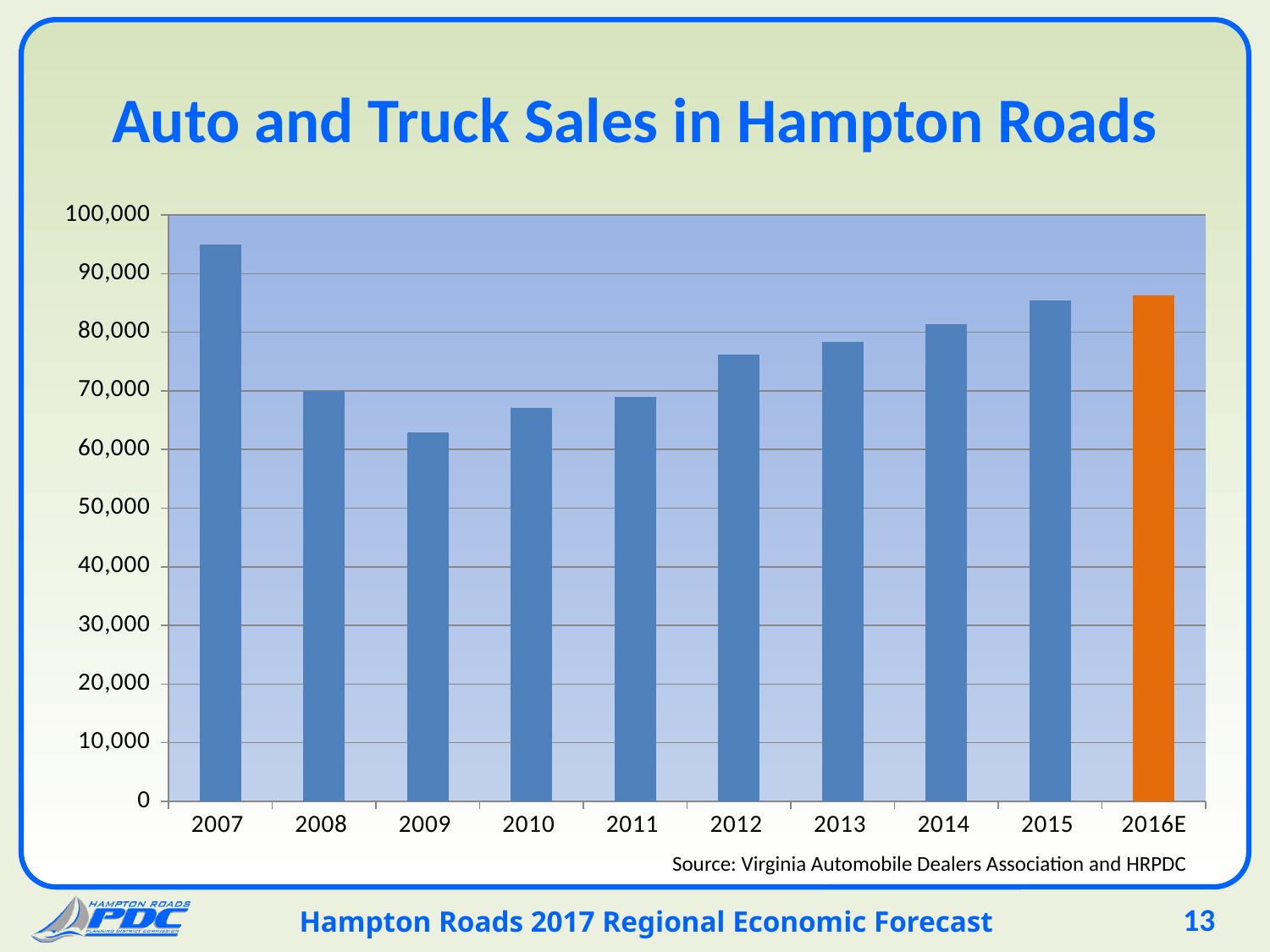
Which year has the lowest auto and truck sales? 2009 Which year has the highest auto and truck sales? 2007 How many years are shown on the x axis of the chart? 10 Is the value for 2012 greater or less than 70,000? greater Is the value for 2013 greater or less than 80,000? less Is the value for 2007 greater or less than 90,000? greater What is the title of the chart? Auto and Truck Sales in Hampton Roads Which is larger, the value for 2007 or the value for 2015? 2007 Do the values rise or fall from 2009 to 2015? rise What kind of chart is shown on the slide? bar chart